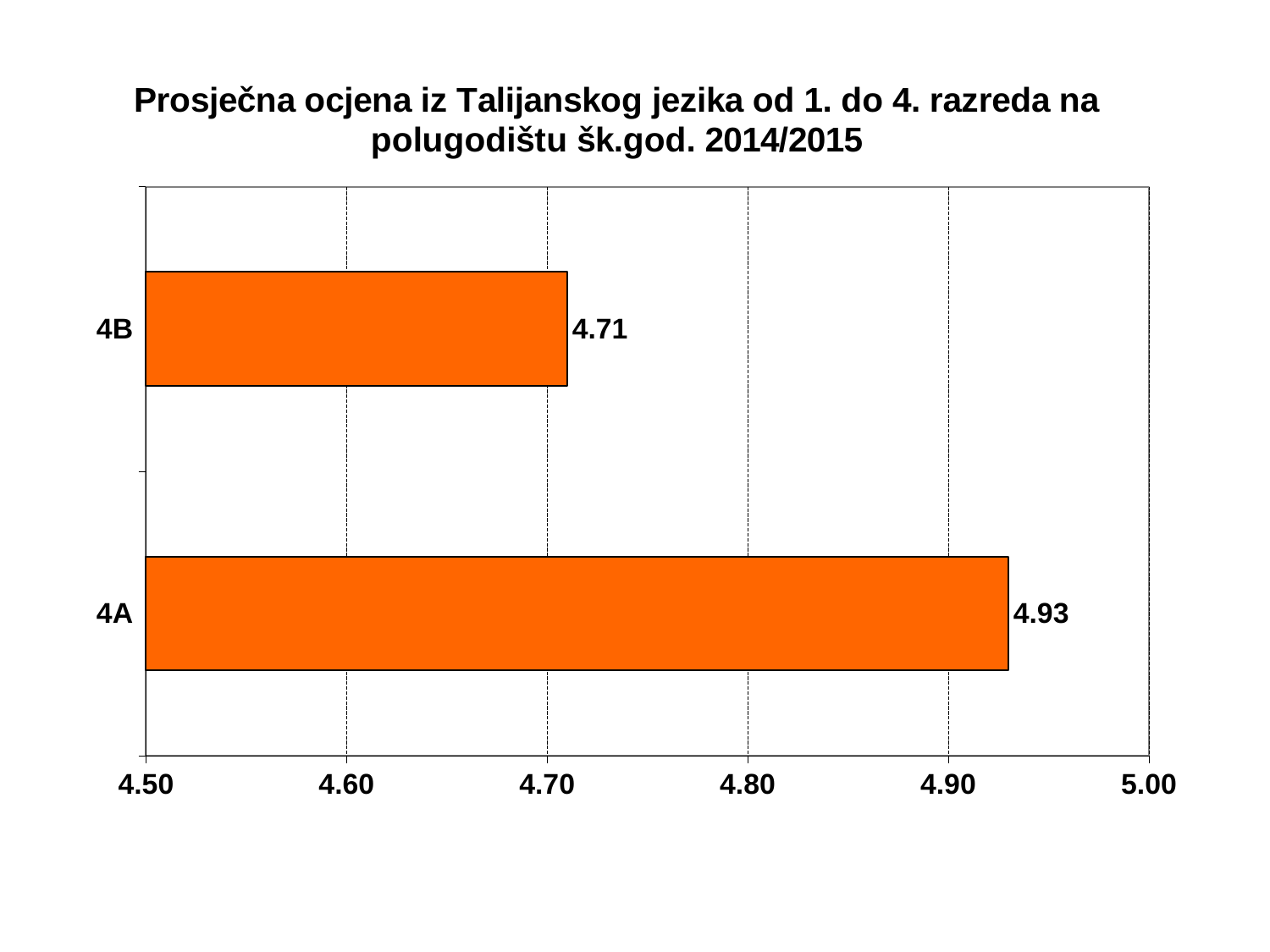
Which category has the highest value? 4A Which category has the lowest value? 4B Is the value for 4B greater or less than 4.80? less What colour are the bars in the chart? orange What kind of chart is shown on the slide? bar chart What is the difference between the values for 4A and 4B? 0.22 How many categories are shown in the chart? 2 What is the value for 4A? 4.93 What is the value for 4B? 4.71 Is the value for 4A greater or less than 4.90? greater Which is larger, the value for 4A or the value for 4B? 4A What is the title of the chart? Prosječna ocjena iz Talijanskog jezika od 1. do 4. razreda na polugodištu šk.god. 2014/2015